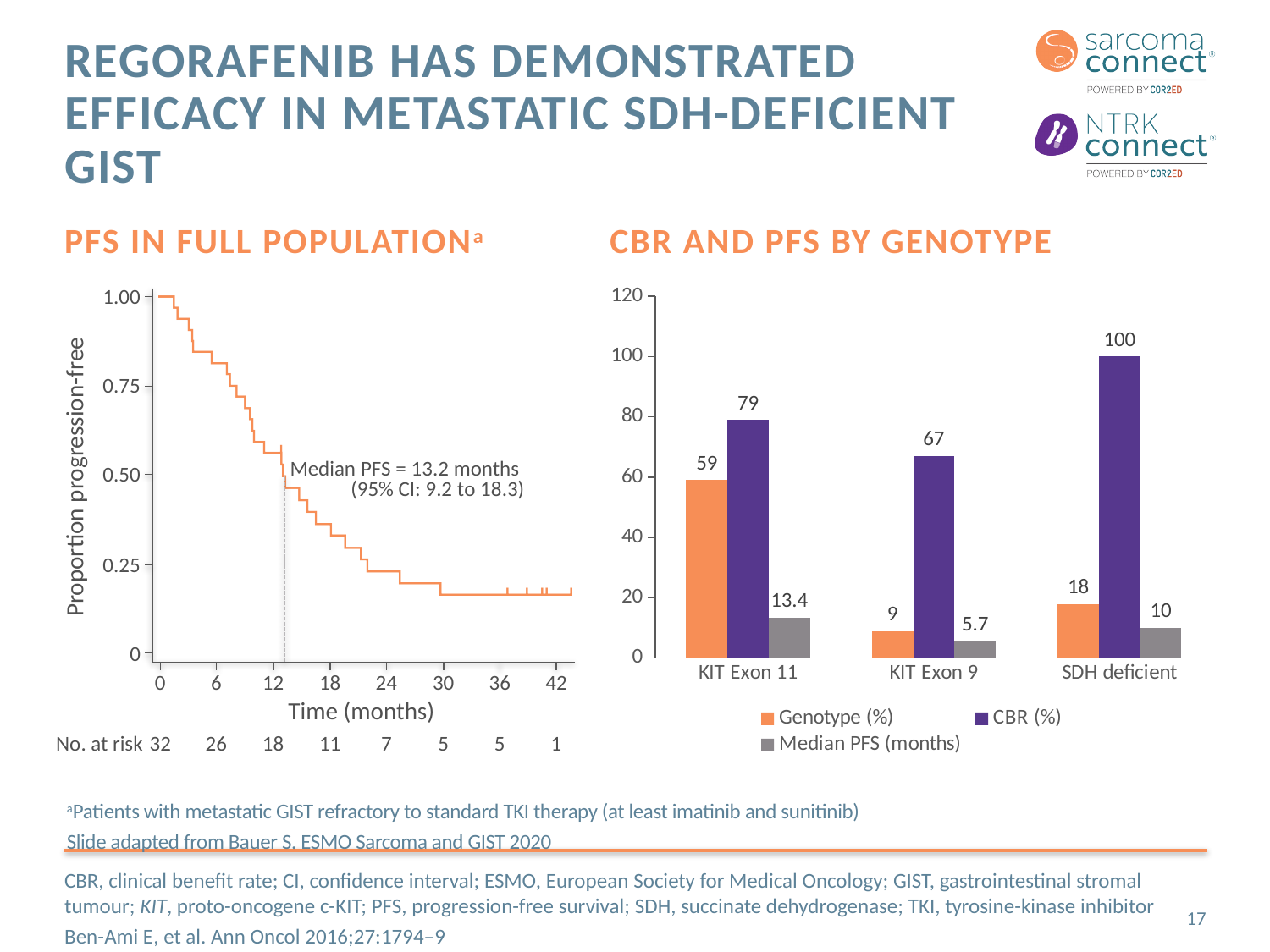
In the 'CBR and PFS by genotype' chart, what is the Median PFS (months) for KIT Exon 9? 5.7 In the 'PFS in full population' chart, what is the number at risk at 18 months? 11 How many series does the legend of the 'CBR and PFS by genotype' chart list? 3 How many genotype categories are shown on the x axis of the 'CBR and PFS by genotype' chart? 3 What kind of chart is the 'CBR and PFS by genotype' chart? Bar chart In the 'CBR and PFS by genotype' chart, what is the Genotype (%) value for KIT Exon 11? 59 In the 'CBR and PFS by genotype' chart, which genotype has the highest CBR (%)? SDH deficient In the 'CBR and PFS by genotype' chart, what is the difference between the CBR (%) for KIT Exon 11 and KIT Exon 9? 12 In the 'CBR and PFS by genotype' chart, is the Median PFS (months) larger for KIT Exon 11 or SDH deficient? KIT Exon 11 In the 'CBR and PFS by genotype' chart, which genotype has the lowest Genotype (%) value? KIT Exon 9 In the 'PFS in full population' chart, what is the median PFS stated on the plot? 13.2 months In the 'CBR and PFS by genotype' chart, what is the CBR (%) for SDH deficient? 100